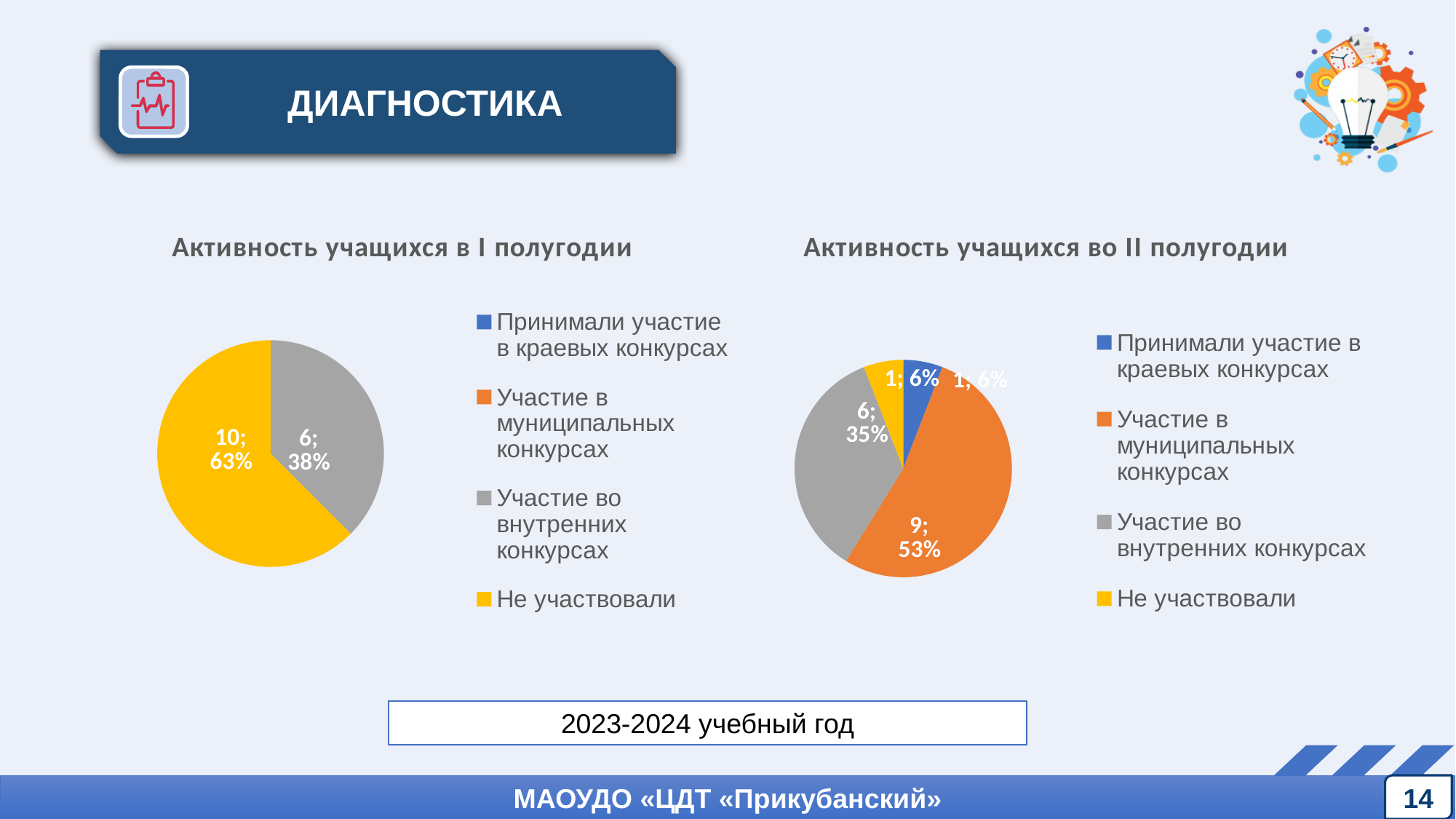
In the chart "Активность учащихся в I полугодии", how many entries does the legend list? 4 In the chart "Активность учащихся во II полугодии", what colour is the slice for "Не участвовали"? yellow In the chart "Активность учащихся во II полугодии", what is the value for "Участие в муниципальных конкурсах"? 9 In the chart "Активность учащихся в I полугодии", what is the value for "Участие во внутренних конкурсах"? 6 What kind of chart is "Активность учащихся в I полугодии"? pie chart In the chart "Активность учащихся во II полугодии", which is larger: "Участие во внутренних конкурсах" or "Не участвовали"? Участие во внутренних конкурсах In the chart "Активность учащихся в I полугодии", which category has the largest slice? Не участвовали In the chart "Активность учащихся в I полугодии", what share of the pie is "Не участвовали"? 63% In the chart "Активность учащихся во II полугодии", what share of the pie is "Принимали участие в краевых конкурсах"? 6% In the chart "Активность учащихся во II полугодии", which category has the largest slice? Участие в муниципальных конкурсах In the chart "Активность учащихся во II полугодии", what is the difference between the values for "Участие в муниципальных конкурсах" and "Участие во внутренних конкурсах"? 3 In the chart "Активность учащихся во II полугодии", what share of the pie is "Участие во внутренних конкурсах"? 35%